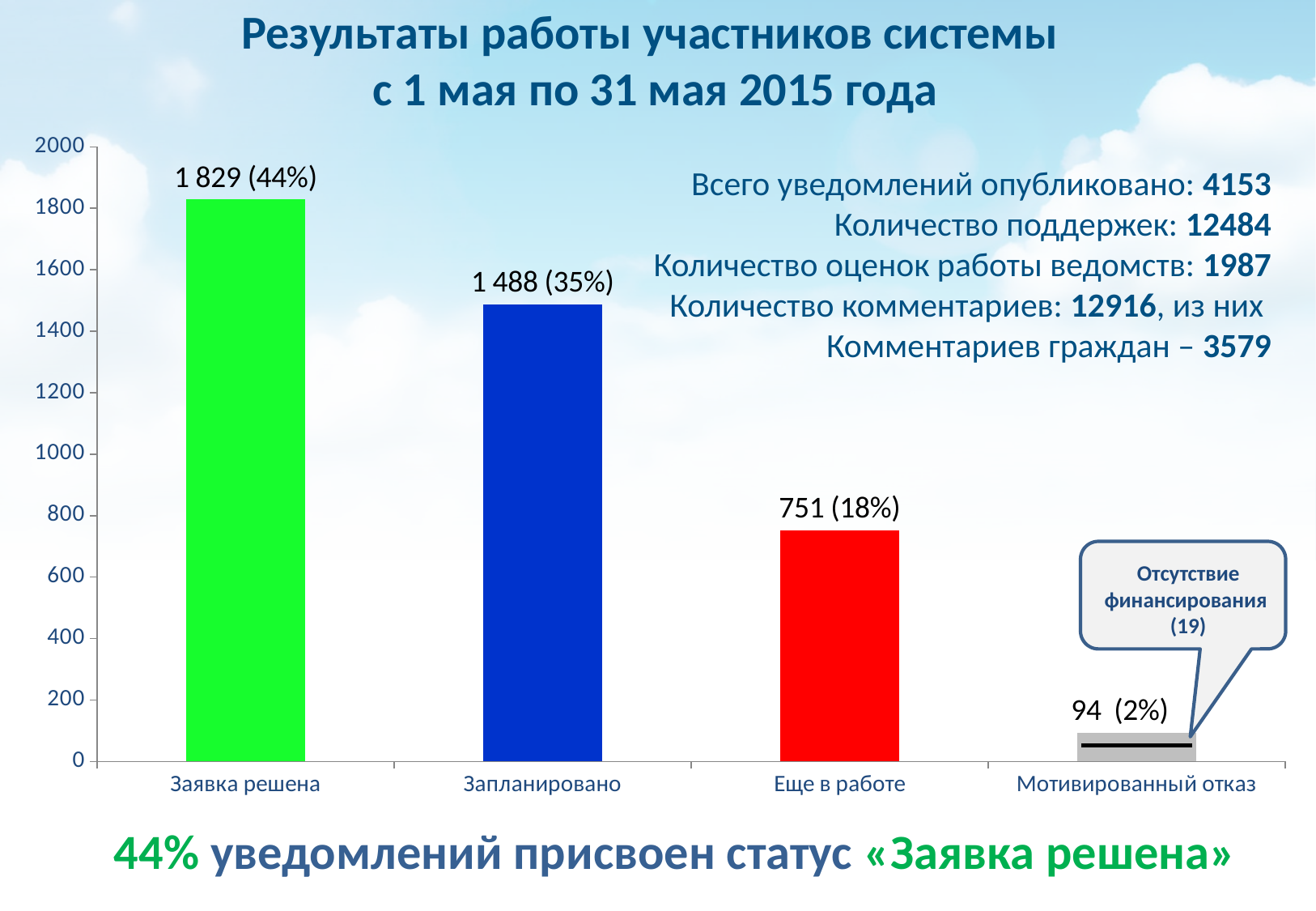
What is the value shown for the category «Мотивированный отказ»? 94 (2%) Which is larger, the value for «Запланировано» or the value for «Еще в работе»? Запланировано What kind of chart is shown on the slide? bar chart What is the value shown for the category «Заявка решена»? 1 829 (44%) Which category has the highest value? Заявка решена What is the value shown for the category «Еще в работе»? 751 (18%) What is the difference between the values for «Заявка решена» and «Запланировано»? 341 How many categories are shown on the x axis of the chart? 4 What is the difference between the values for «Еще в работе» and «Мотивированный отказ»? 657 Which category has the lowest value? Мотивированный отказ What is the value shown for the category «Запланировано»? 1 488 (35%) Is the value for «Еще в работе» greater or less than 800? less